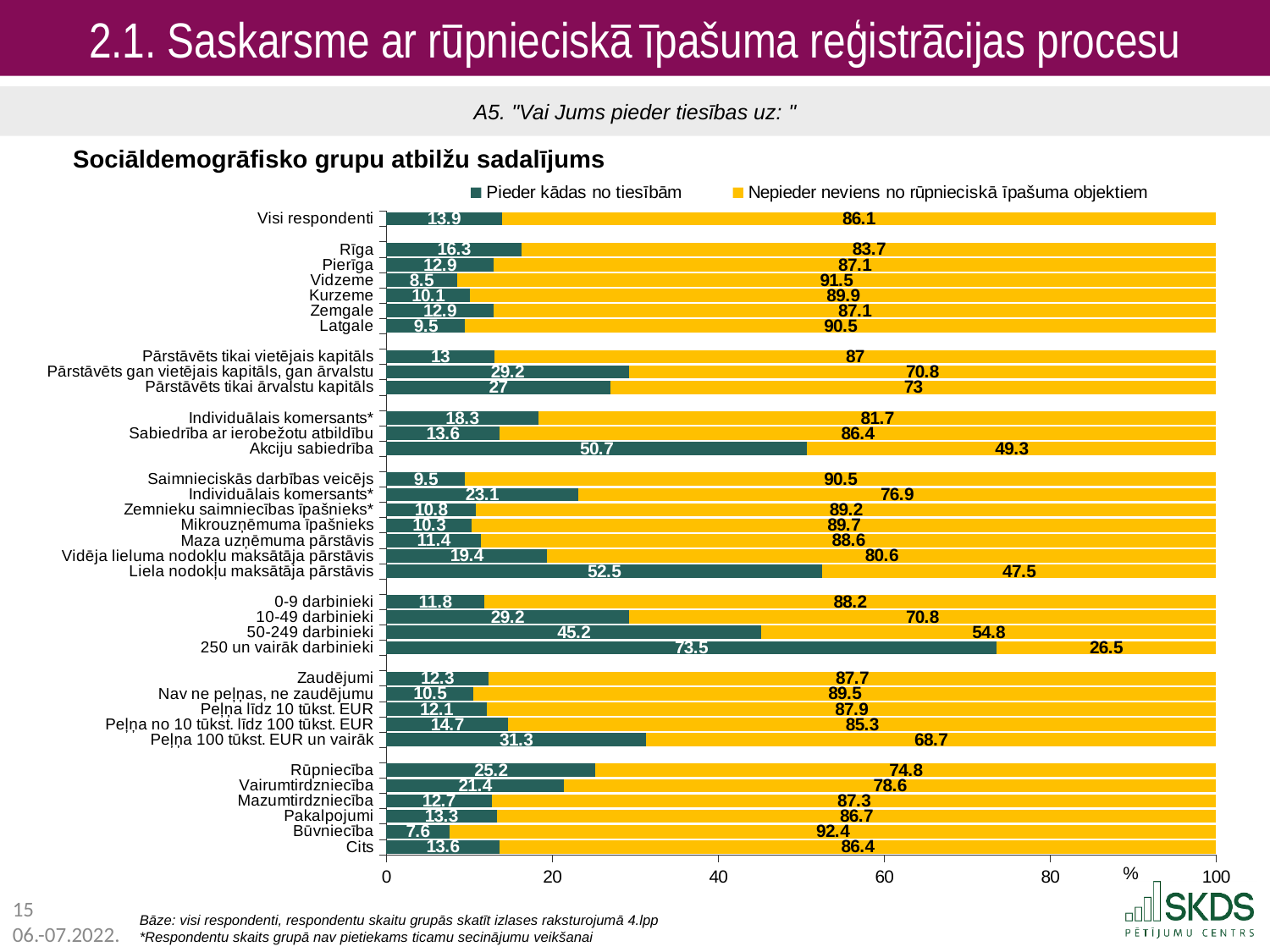
What type of chart is shown on the slide? stacked bar chart Which category has the highest value for "Pieder kādas no tiesībām"? 250 un vairāk darbinieki What is the value of "Pieder kādas no tiesībām" for Visi respondenti? 13.9 What is the value of "Nepieder neviens no rūpnieciskā īpašuma objektiem" for Peļņa 100 tūkst. EUR un vairāk? 68.7 Which category has the lowest value for "Pieder kādas no tiesībām"? Būvniecība What is the value of "Nepieder neviens no rūpnieciskā īpašuma objektiem" for Vidzeme? 91.5 How many series does the legend list? 2 What is the total of the stacked bar for 50-249 darbinieki? 100 Which has a larger "Pieder kādas no tiesībām" value, Rūpniecība or Vairumtirdzniecība? Rūpniecība What is the value of "Pieder kādas no tiesībām" for Akciju sabiedrība? 50.7 What is the difference between the "Pieder kādas no tiesībām" values for Rīga and Latgale? 6.8 How many categories are plotted on the chart? 35